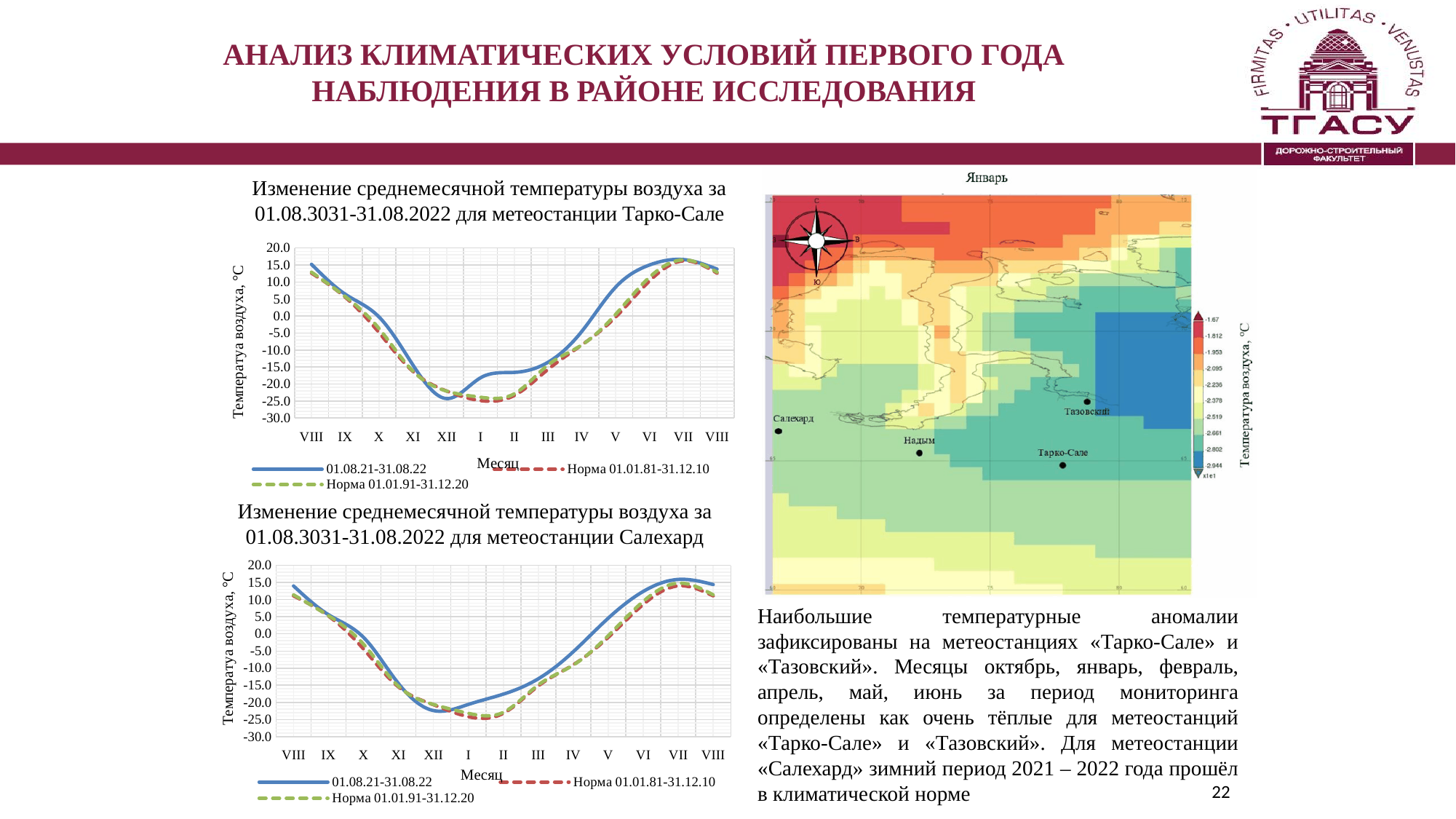
In the Салехард chart, do the values of the 01.08.21-31.08.22 series rise or fall from month I to month VII? rise In the Тарко-Сале chart, do the values of the 01.08.21-31.08.22 series rise or fall from month VIII to month XII? fall In the Тарко-Сале chart, which month has the lowest value for the 01.08.21-31.08.22 series? XII In the Тарко-Сале chart, for month II, which series has the higher value: 01.08.21-31.08.22 or Норма 01.01.81-31.12.10? 01.08.21-31.08.22 In the Салехард chart, is the value of the 01.08.21-31.08.22 series for month XII greater or less than -20.0? less In the Тарко-Сале chart, is the value of the 01.08.21-31.08.22 series for month II greater or less than -20.0? greater How many series does the legend list in the Тарко-Сале temperature chart? 3 What is the label of the y axis in the Салехард temperature chart? Температуа воздуха, °С In the Салехард chart, is the value of the 01.08.21-31.08.22 series for month V greater or less than 0.0? greater How many month labels are shown on the x axis of the Салехард temperature chart? 13 What kind of chart is the chart titled "Изменение среднемесячной температуры воздуха за 01.08.3031-31.08.2022 для метеостанции Тарко-Сале"? line chart